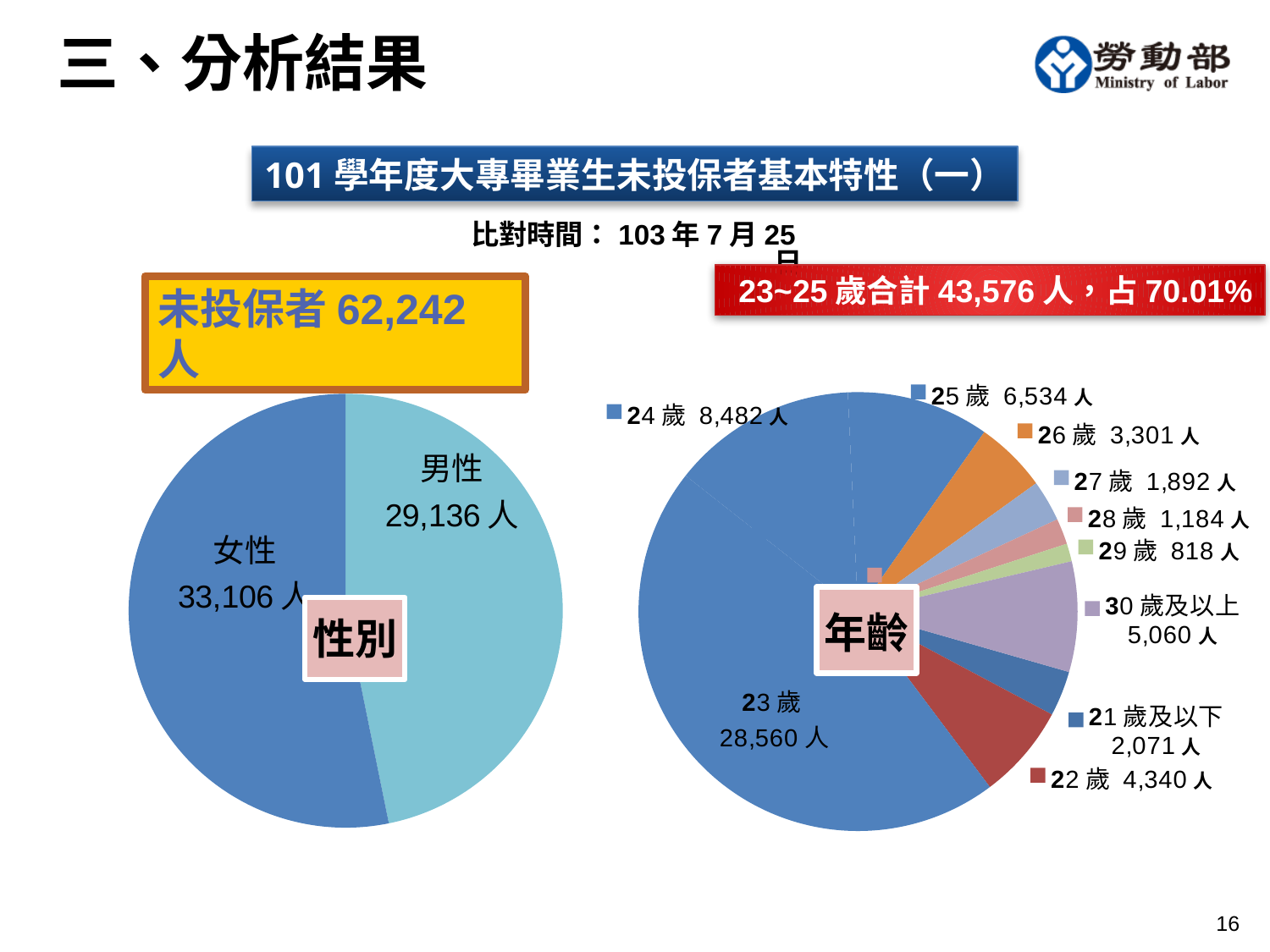
In the 年齡 pie chart, which age group has the smallest value? 29 歲 In the 年齡 pie chart, what is the value for 30 歲及以上? 5,060 人 In the 性別 pie chart, what is the value for 男性? 29,136 人 How many slices does the 年齡 pie chart have? 10 What kind of chart is the 性別 chart on the left? pie chart According to the slide, what share of the 年齡 pie do the 23~25 歲 groups make up together? 70.01% In the 年齡 pie chart, what is the difference between 24 歲 and 25 歲? 1,948 人 In the 年齡 pie chart, which age group has the largest value? 23 歲 In the 性別 pie chart, what is the difference between 女性 and 男性? 3,970 人 In the 年齡 pie chart, what is the value for 23 歲? 28,560 人 In the 性別 pie chart, which category is larger, 女性 or 男性? 女性 In the 性別 pie chart, what is the value for 女性? 33,106 人